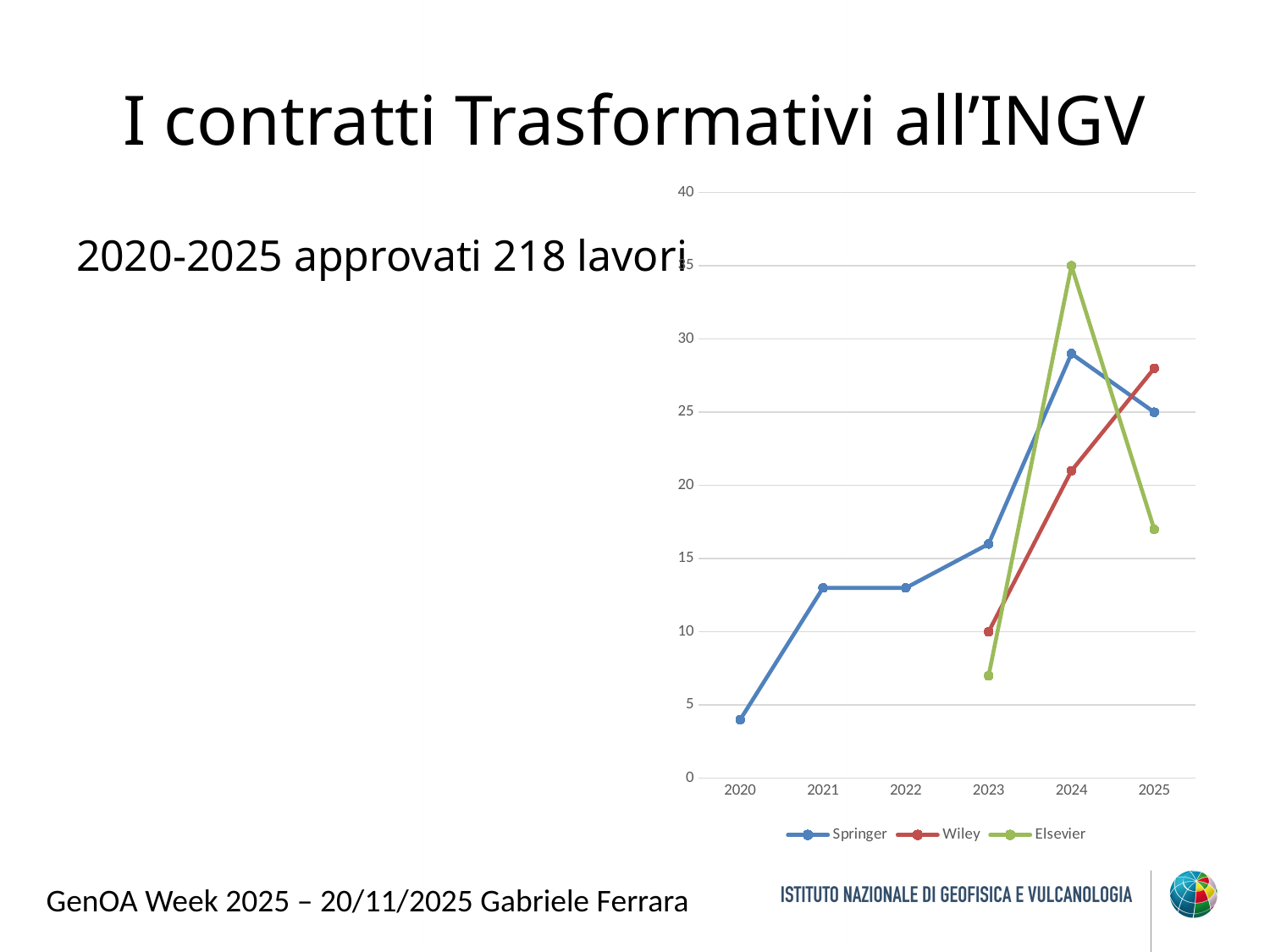
What kind of chart is shown on the slide? line chart Which series has the highest value in 2024? Elsevier Is the value for Springer in 2024 greater or less than 25? greater Is the value for Wiley in 2024 greater or less than 20? greater Does the Elsevier line rise or fall from 2024 to 2025? fall Is the value for Elsevier in 2025 greater or less than 20? less Which publishers are listed in the chart legend? Springer, Wiley, Elsevier How many series does the chart legend list? 3 Which series has the lowest value in 2023? Elsevier How many years are shown on the x axis of the chart? 6 In 2025, which series has the larger value, Wiley or Elsevier? Wiley